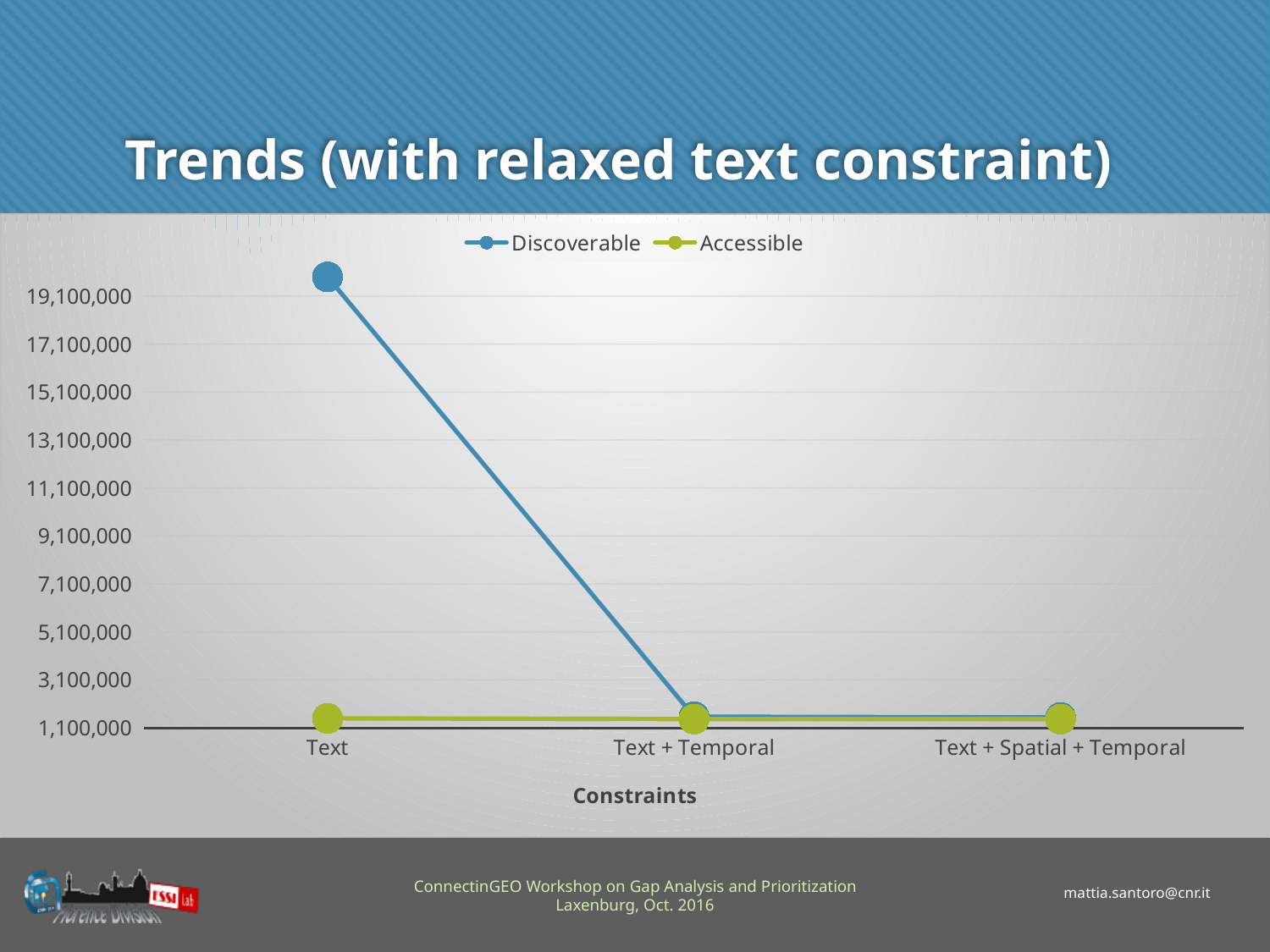
How many categories are shown on the x axis? 3 Does the Discoverable series rise or fall from Text to Text + Temporal? fall What is the title of the x axis? Constraints At the Text constraint, which series has the larger value, Discoverable or Accessible? Discoverable Is the Discoverable value for Text + Temporal greater or less than 3,100,000? less What kind of chart is shown on the slide? line chart For which constraint is the Discoverable series highest? Text Is the Discoverable value for Text greater or less than 19,100,000? greater Is the Accessible value for Text greater or less than 3,100,000? less What colour is the Accessible series line? green How many series does the legend list? 2 What is the title of the slide? Trends (with relaxed text constraint)